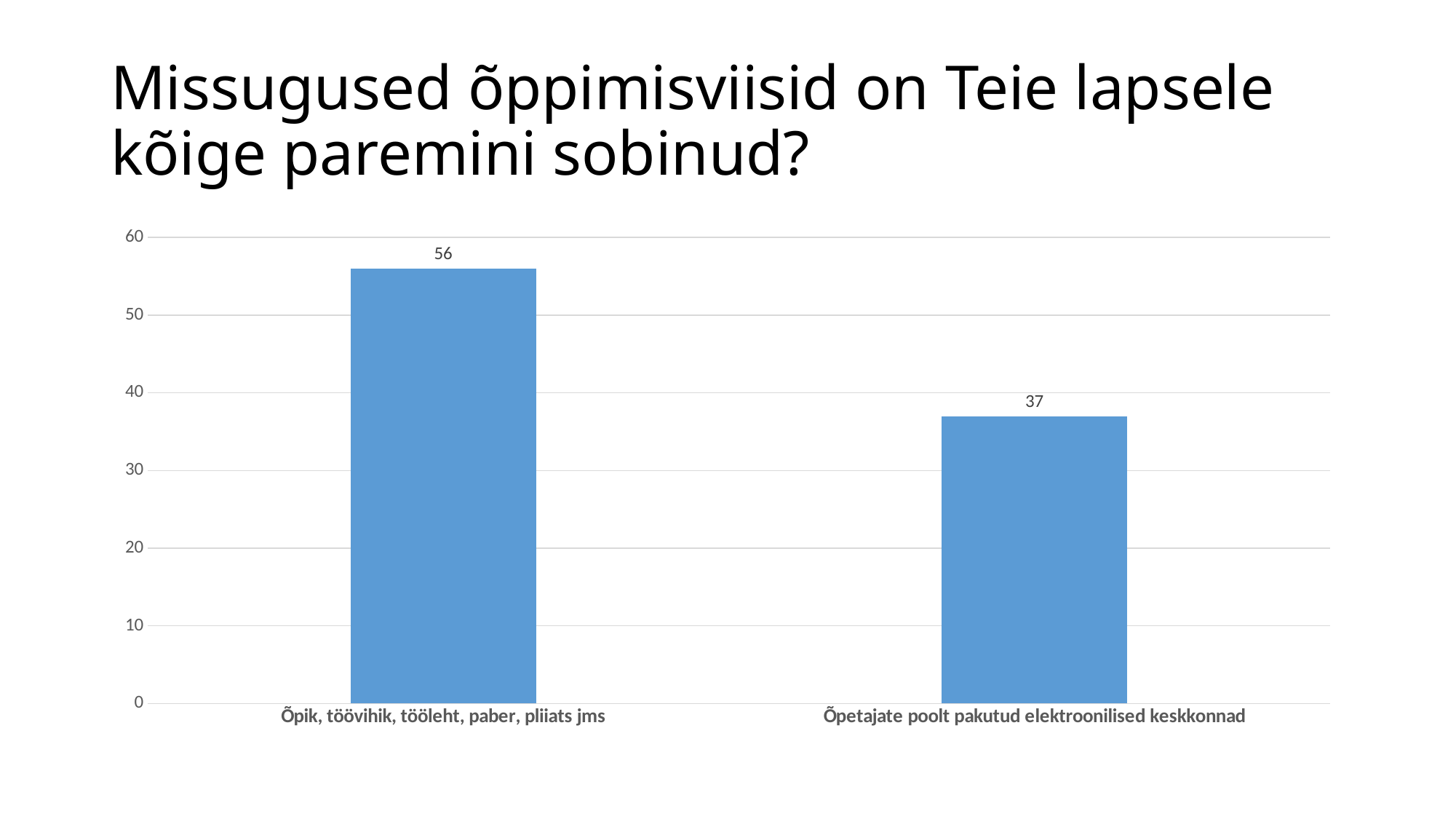
Is the value for "Õpik, töövihik, tööleht, paber, pliiats jms" greater or less than 50? greater Which category has the highest value? Õpik, töövihik, tööleht, paber, pliiats jms What is the total of the two values shown in the chart? 93 What kind of chart is shown on the slide? bar chart Which is larger: the value for "Õpik, töövihik, tööleht, paber, pliiats jms" or for "Õpetajate poolt pakutud elektroonilised keskkonnad"? Õpik, töövihik, tööleht, paber, pliiats jms What is the value for "Õpetajate poolt pakutud elektroonilised keskkonnad"? 37 What is the title of the slide? Missugused õppimisviisid on Teie lapsele kõige paremini sobinud? What is the difference between the values for "Õpik, töövihik, tööleht, paber, pliiats jms" and "Õpetajate poolt pakutud elektroonilised keskkonnad"? 19 How many categories are shown in the chart? 2 Which category has the lowest value? Õpetajate poolt pakutud elektroonilised keskkonnad What is the value for "Õpik, töövihik, tööleht, paber, pliiats jms"? 56 Is the value for "Õpetajate poolt pakutud elektroonilised keskkonnad" greater or less than 40? less